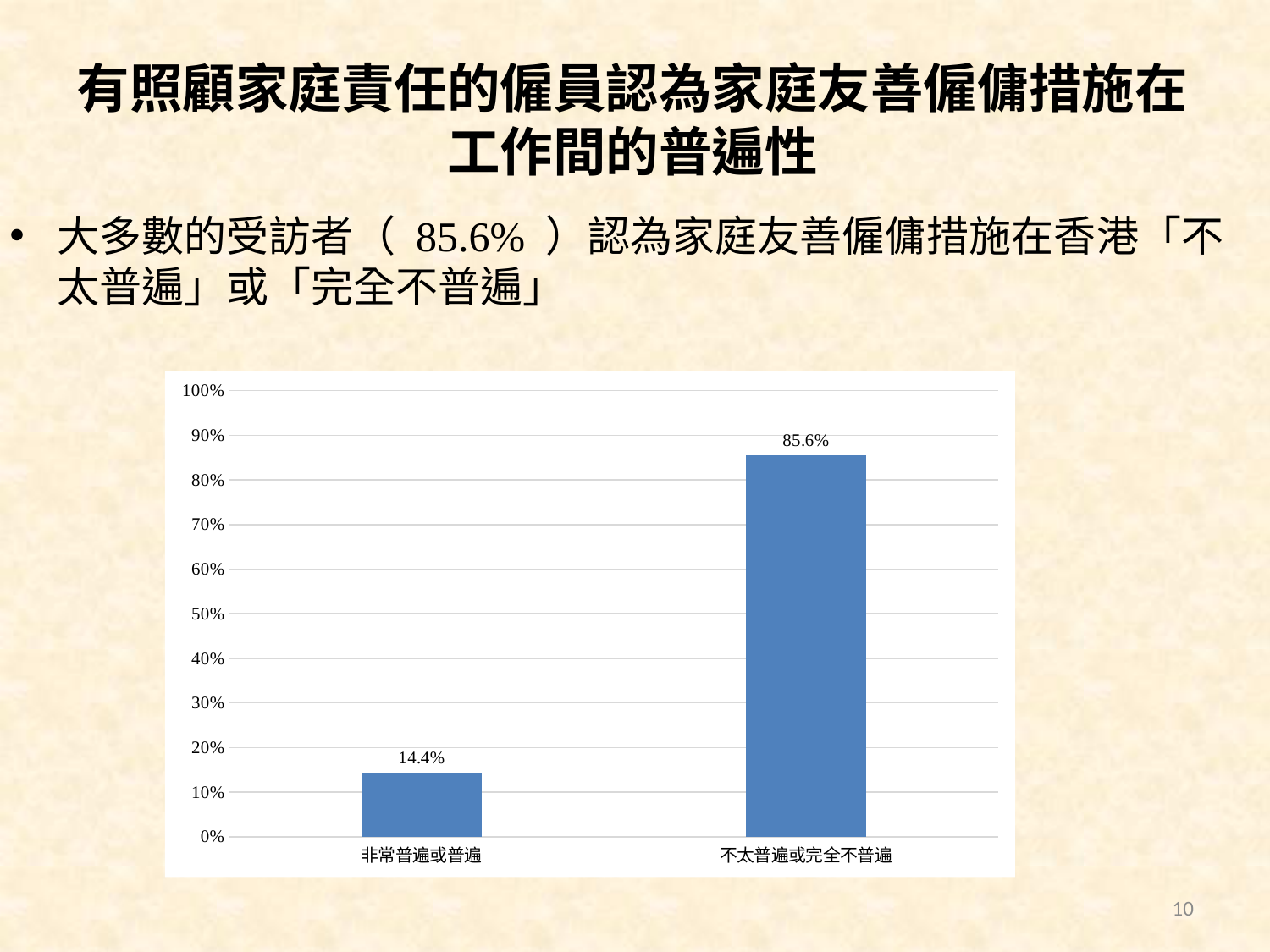
Which is larger, the value for 非常普遍或普遍 or the value for 不太普遍或完全不普遍? 不太普遍或完全不普遍 What is the value for 非常普遍或普遍? 14.4% Which category has the lowest value? 非常普遍或普遍 Which category has the highest value? 不太普遍或完全不普遍 What is the maximum value shown on the y axis? 100% Is the value for 不太普遍或完全不普遍 greater or less than 80%? greater What is the difference between the values for 不太普遍或完全不普遍 and 非常普遍或普遍? 71.2% What is the value for 不太普遍或完全不普遍? 85.6% How many categories are shown on the x axis? 2 What is the total of the two bars' values? 100% What kind of chart is shown on the slide? bar chart Is the value for 非常普遍或普遍 greater or less than 20%? less